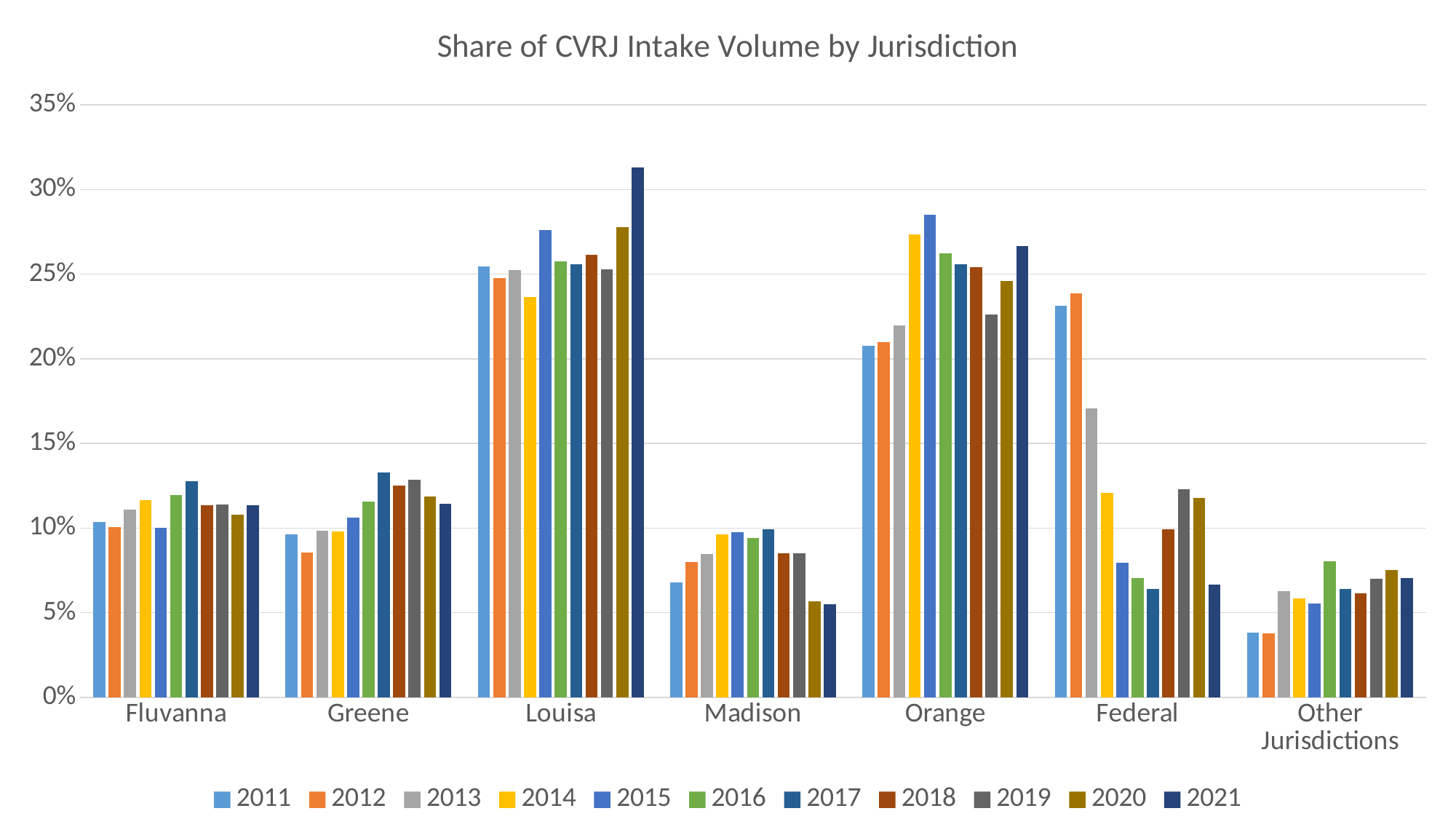
Which is larger for Federal: the 2011 value or the 2021 value? 2011 Is the value for Greene in 2017 greater or less than 10%? greater How many series does the legend list? 11 Is the value for Louisa in 2021 greater or less than 30%? greater For Louisa, which year has the highest value? 2021 Is the value for Other Jurisdictions in 2011 greater or less than 5%? less How many jurisdiction categories are shown on the x axis? 7 Which jurisdiction has the highest value for 2021? Louisa What is the title of the chart? Share of CVRJ Intake Volume by Jurisdiction Do the Federal values rise or fall from 2011 to 2017? fall What type of chart is shown on the slide? bar chart